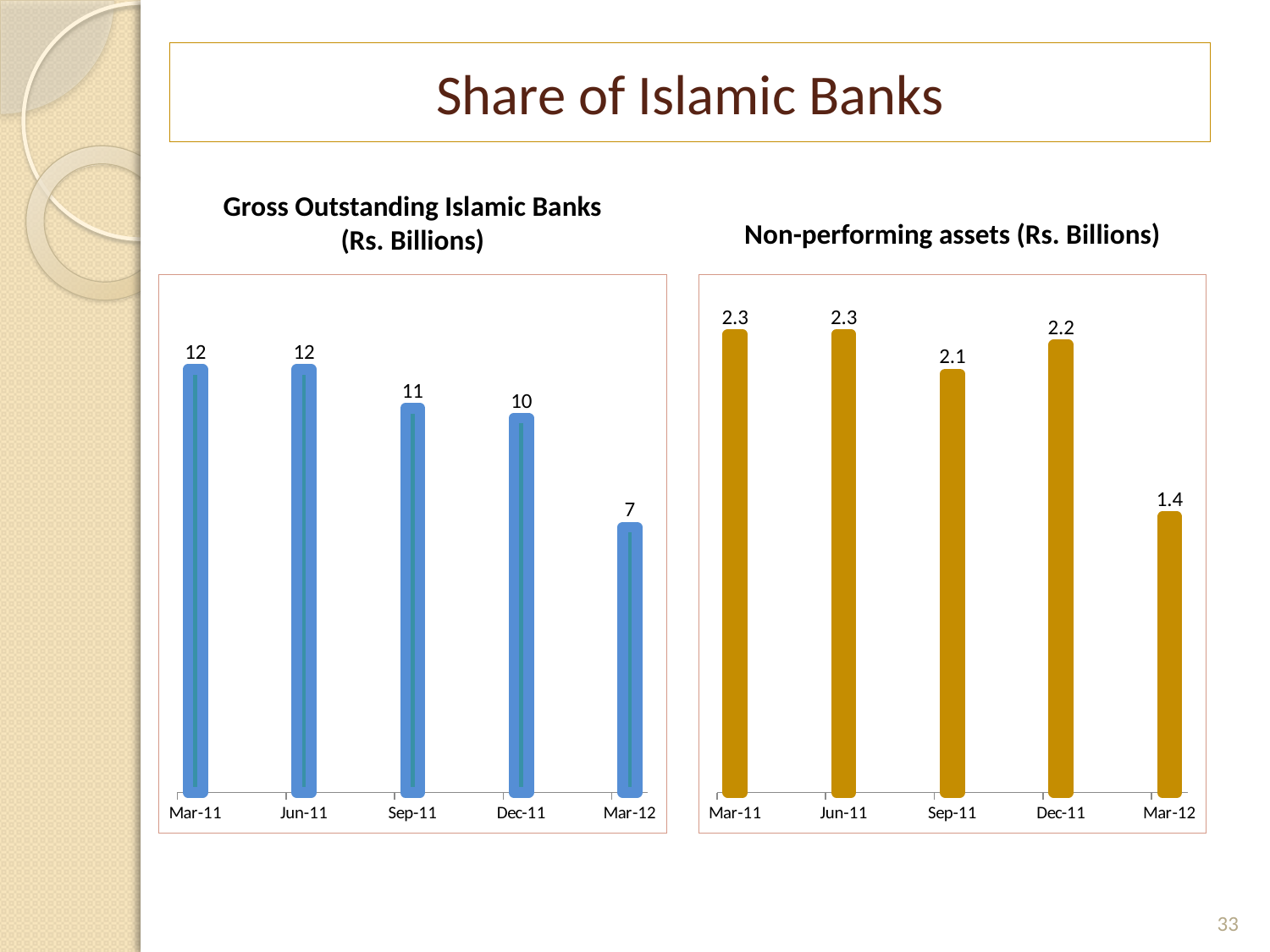
In the 'Non-performing assets (Rs. Billions)' chart, what is the value for Dec-11? 2.2 How many periods are shown on the x axis of the 'Gross Outstanding Islamic Banks (Rs. Billions)' chart? 5 In the 'Gross Outstanding Islamic Banks (Rs. Billions)' chart, what is the value for Sep-11? 11 In the 'Non-performing assets (Rs. Billions)' chart, which is larger, the value for Dec-11 or the value for Mar-12? Dec-11 In the 'Non-performing assets (Rs. Billions)' chart, which period has the lowest value? Mar-12 What kind of chart is the 'Non-performing assets (Rs. Billions)' chart? Bar chart In the 'Gross Outstanding Islamic Banks (Rs. Billions)' chart, what is the difference between the Jun-11 and Mar-12 values? 5 In the 'Non-performing assets (Rs. Billions)' chart, what is the value for Mar-12? 1.4 In the 'Gross Outstanding Islamic Banks (Rs. Billions)' chart, do the values generally rise or fall from Mar-11 to Mar-12? Fall In the 'Gross Outstanding Islamic Banks (Rs. Billions)' chart, what is the value for Mar-12? 7 In the 'Non-performing assets (Rs. Billions)' chart, what is the difference between the Mar-11 and Sep-11 values? 0.2 In the 'Gross Outstanding Islamic Banks (Rs. Billions)' chart, which period has the lowest value? Mar-12